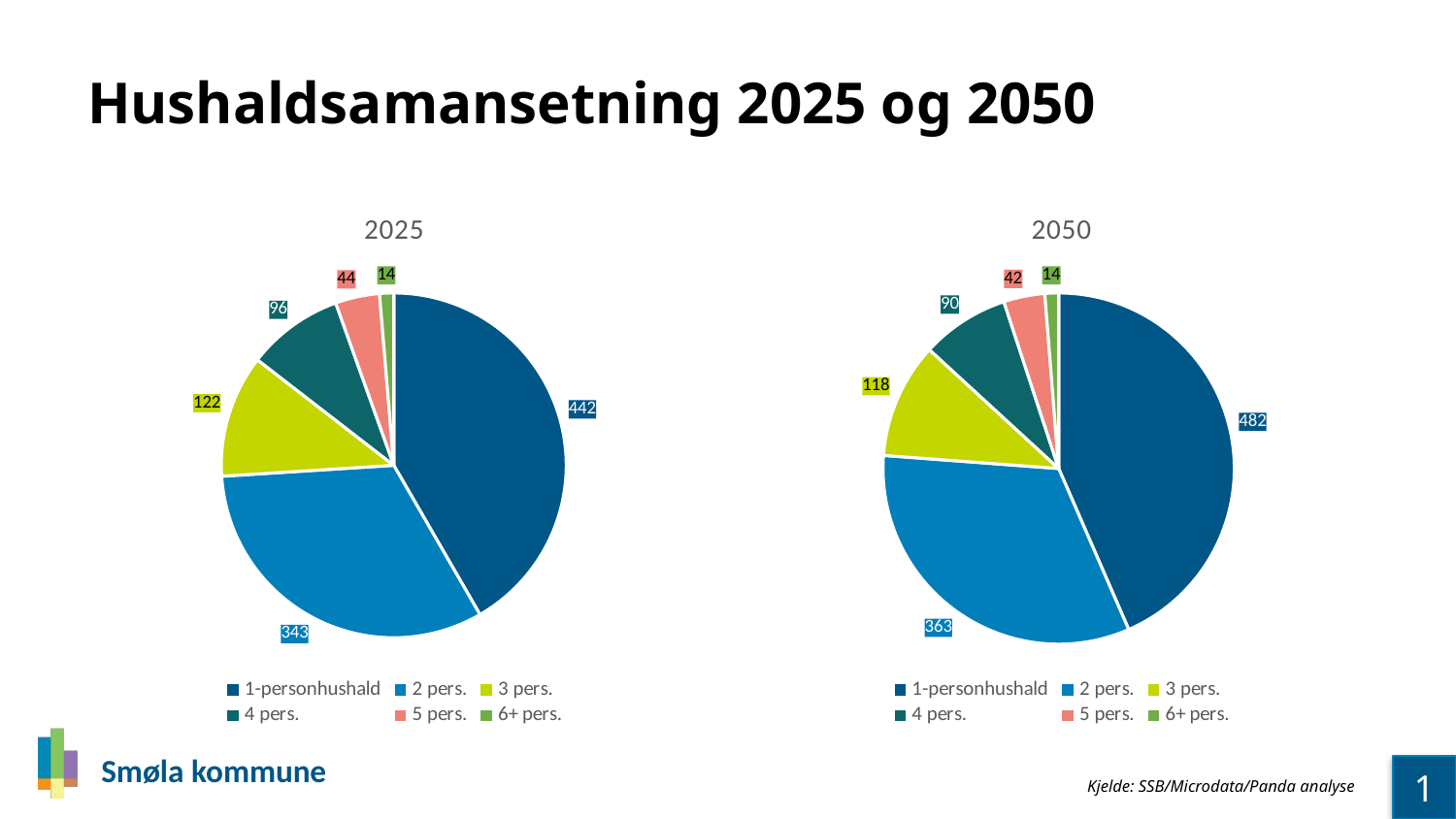
What type of chart is the 2025 chart? pie chart In the 2025 chart, what is the value for 1-personhushald? 442 In the 2050 chart, what is the value for 2 pers.? 363 In the 2050 chart, which category has the largest slice? 1-personhushald What is the title of the slide? Hushaldsamansetning 2025 og 2050 In the 2050 chart, what is the value for 4 pers.? 90 In the 2025 chart, which category has the smallest slice? 6+ pers. In the 2025 chart, what is the difference between the 2 pers. and 3 pers. values? 221 Which is larger: the 5 pers. value in the 2025 chart or in the 2050 chart? 2025 In the 2025 chart, what is the value for 3 pers.? 122 What is the difference between the 1-personhushald value in the 2050 chart and in the 2025 chart? 40 How many categories does the 2050 chart show? 6